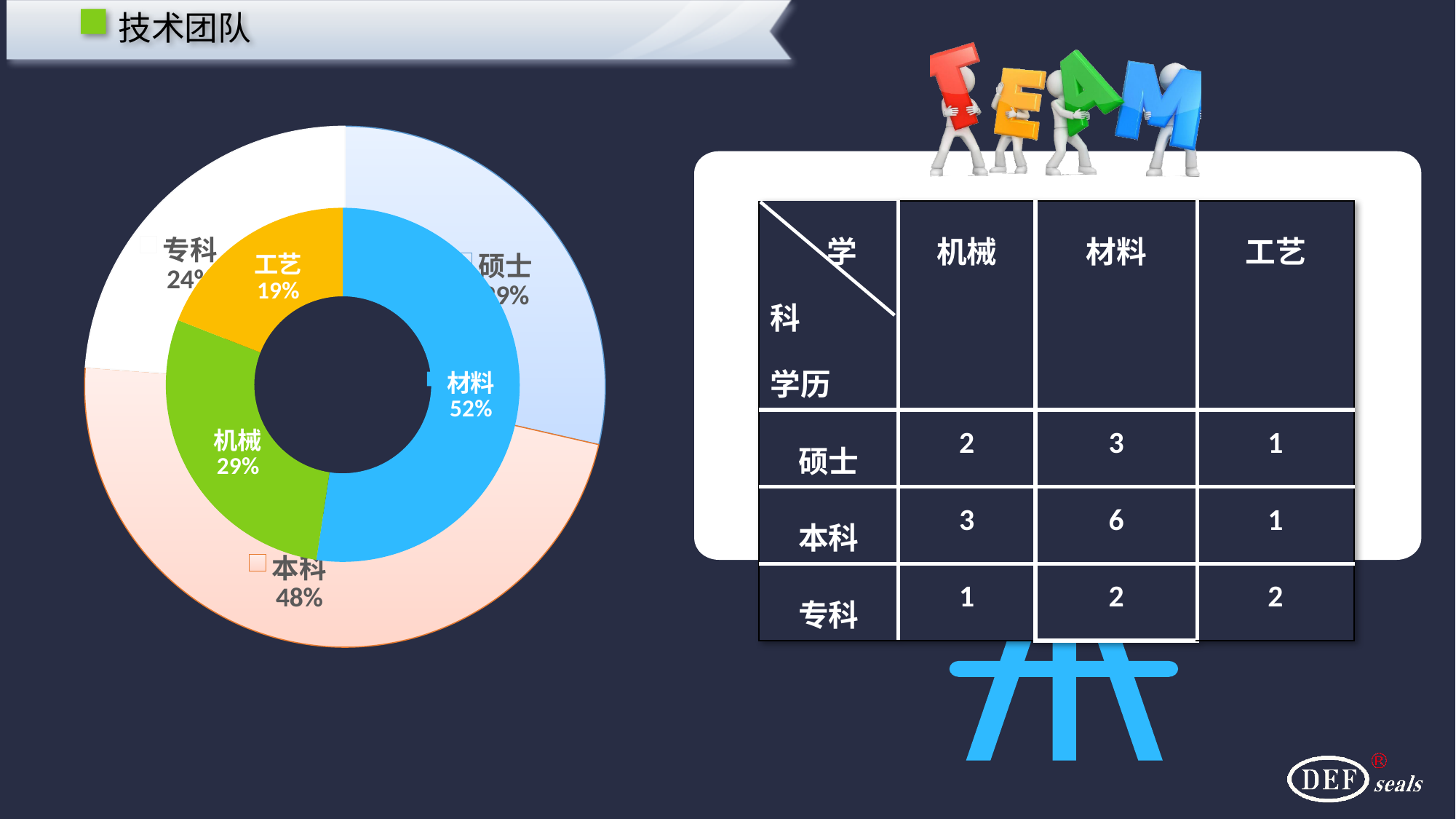
Which category in the inner ring of the doughnut chart has the smallest share? 工艺 How many categories are shown in the inner ring of the doughnut chart? 3 In the inner ring of the doughnut chart, what percentage is shown for 工艺? 19% What kind of chart is shown on the left of the slide? Doughnut chart In the outer ring of the doughnut chart, which is larger, 本科 or 专科? 本科 In the inner ring of the doughnut chart, what percentage is shown for 材料? 52% In the outer ring of the doughnut chart, what percentage is shown for 本科? 48% Which category in the outer ring of the doughnut chart has the largest share? 本科 In the inner ring of the doughnut chart, what percentage is shown for 机械? 29% Which category in the inner ring of the doughnut chart has the largest share? 材料 In the inner ring of the doughnut chart, what is the difference in percentage points between 材料 and 机械? 23% In the inner ring of the doughnut chart, what is the difference in percentage points between 机械 and 工艺? 10%